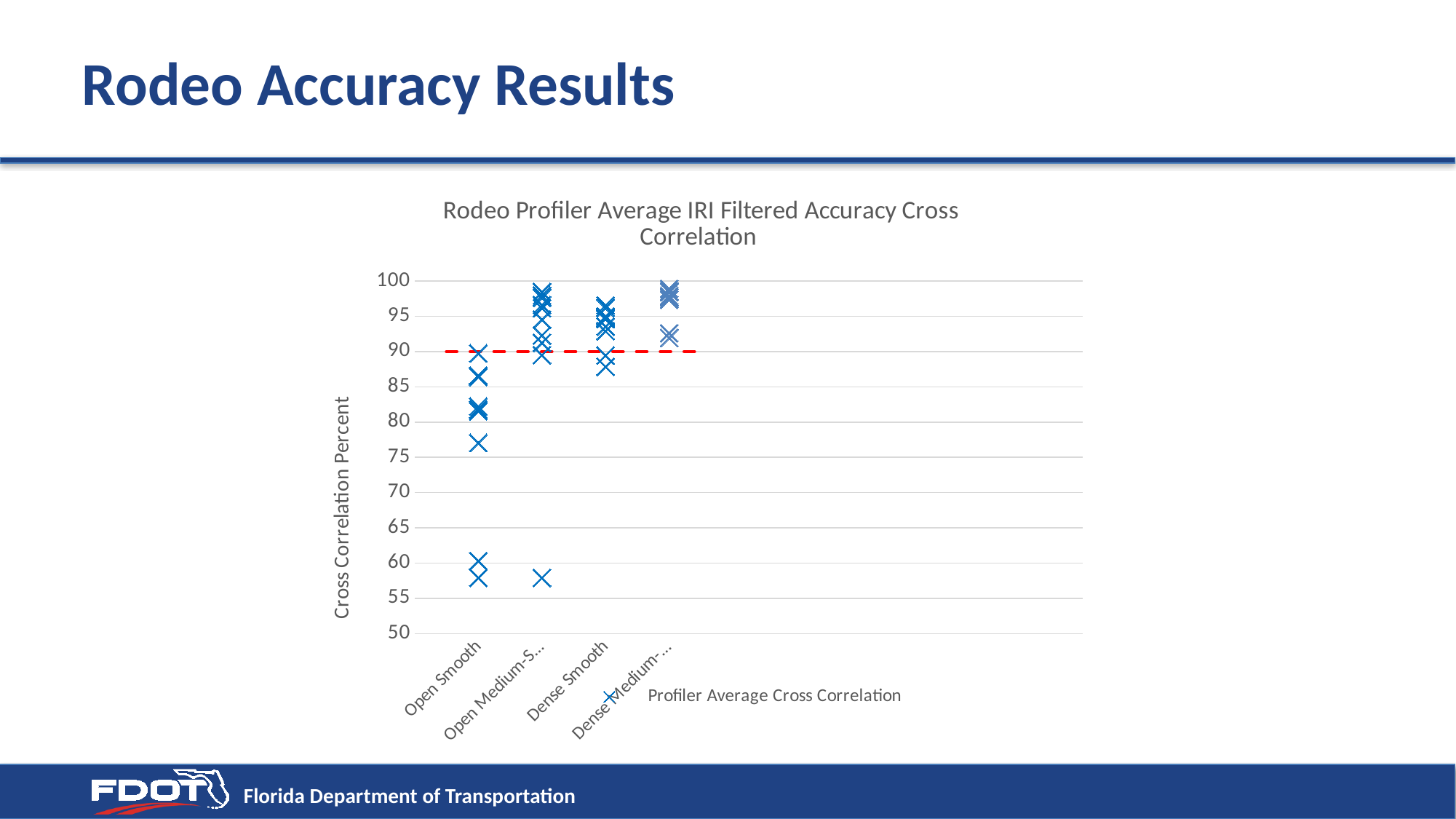
What are the minimum and maximum values shown on the vertical axis? 50 and 100 Is the lowest point for Dense Smooth greater or less than 85? greater How many categories are shown along the x axis? 4 Is the lowest point for Open Smooth greater or less than 60? less How many series does the legend list? 1 Is the highest point for Open Smooth greater or less than 95? less What is the title of the chart? Rodeo Profiler Average IRI Filtered Accuracy Cross Correlation At what value on the vertical axis is the red dashed line drawn? 90 What series name does the chart legend list? Profiler Average Cross Correlation What is the label of the vertical axis? Cross Correlation Percent What kind of chart is shown on the slide? scatter chart